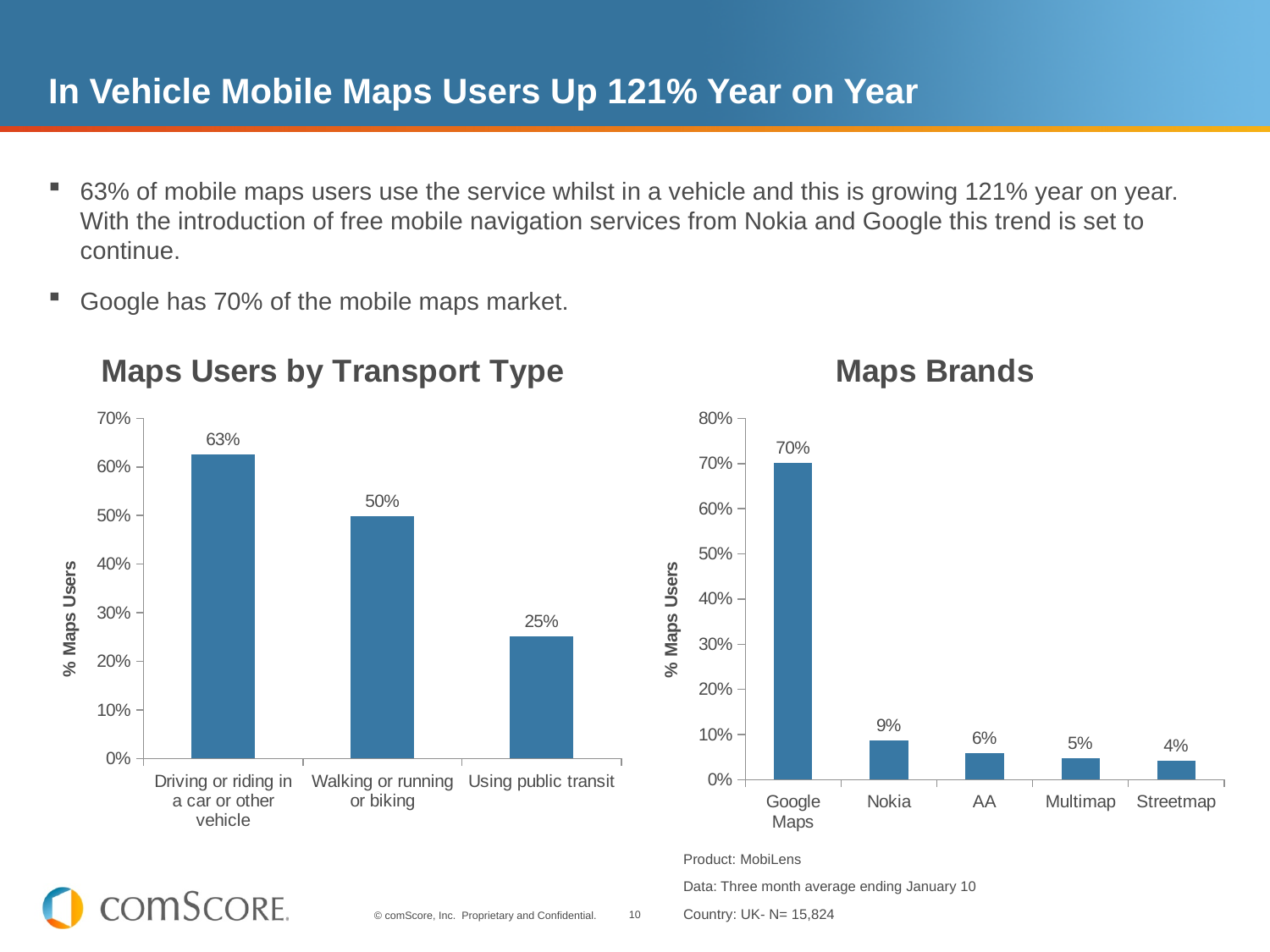
In the 'Maps Brands' chart, which brand has the lowest value? Streetmap In the 'Maps Brands' chart, how many brands are shown? 5 In the 'Maps Brands' chart, what is the difference between Google Maps and Nokia? 61% In the 'Maps Users by Transport Type' chart, which transport type has the lowest value? Using public transit In the 'Maps Users by Transport Type' chart, how many transport types are shown? 3 What kind of chart is the 'Maps Brands' chart? bar chart In the 'Maps Brands' chart, which is larger, AA or Multimap? AA In the 'Maps Users by Transport Type' chart, what is the difference between 'Driving or riding in a car or other vehicle' and 'Using public transit'? 38% In the 'Maps Brands' chart, which brand has the highest value? Google Maps In the 'Maps Users by Transport Type' chart, do the values rise or fall from left to right? fall In the 'Maps Brands' chart, what is the value for Nokia? 9% In the 'Maps Users by Transport Type' chart, what is the value for 'Walking or running or biking'? 50%